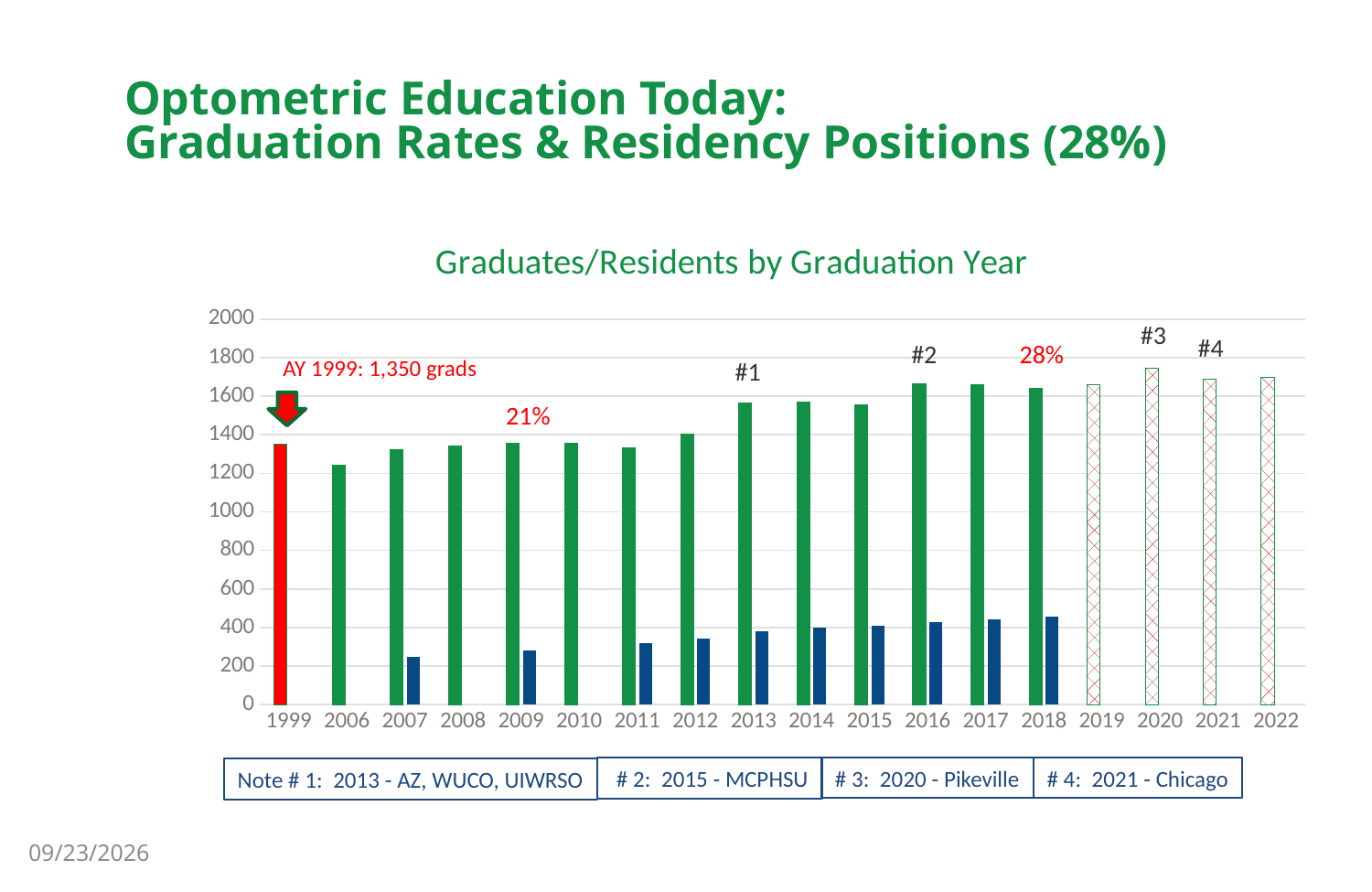
Is the value of the hatched bar for 2020 greater or less than 1600? greater Which year has the lowest tall green bar in the chart? 2006 How many graduation years are shown on the x axis of the chart? 18 Do the short blue bars rise or fall from 2007 to 2018? rise What kind of chart is shown on the slide? bar chart Is the value of the short blue bar for 2007 greater or less than 400? less Which year has the highest short blue bar in the chart? 2018 Is the value of the tall green bar for 2006 greater or less than 1400? less What is the title of the chart? Graduates/Residents by Graduation Year According to the annotation on the chart, how many grads were there in AY 1999? 1,350 Which year has the taller green bar, 2012 or 2013? 2013